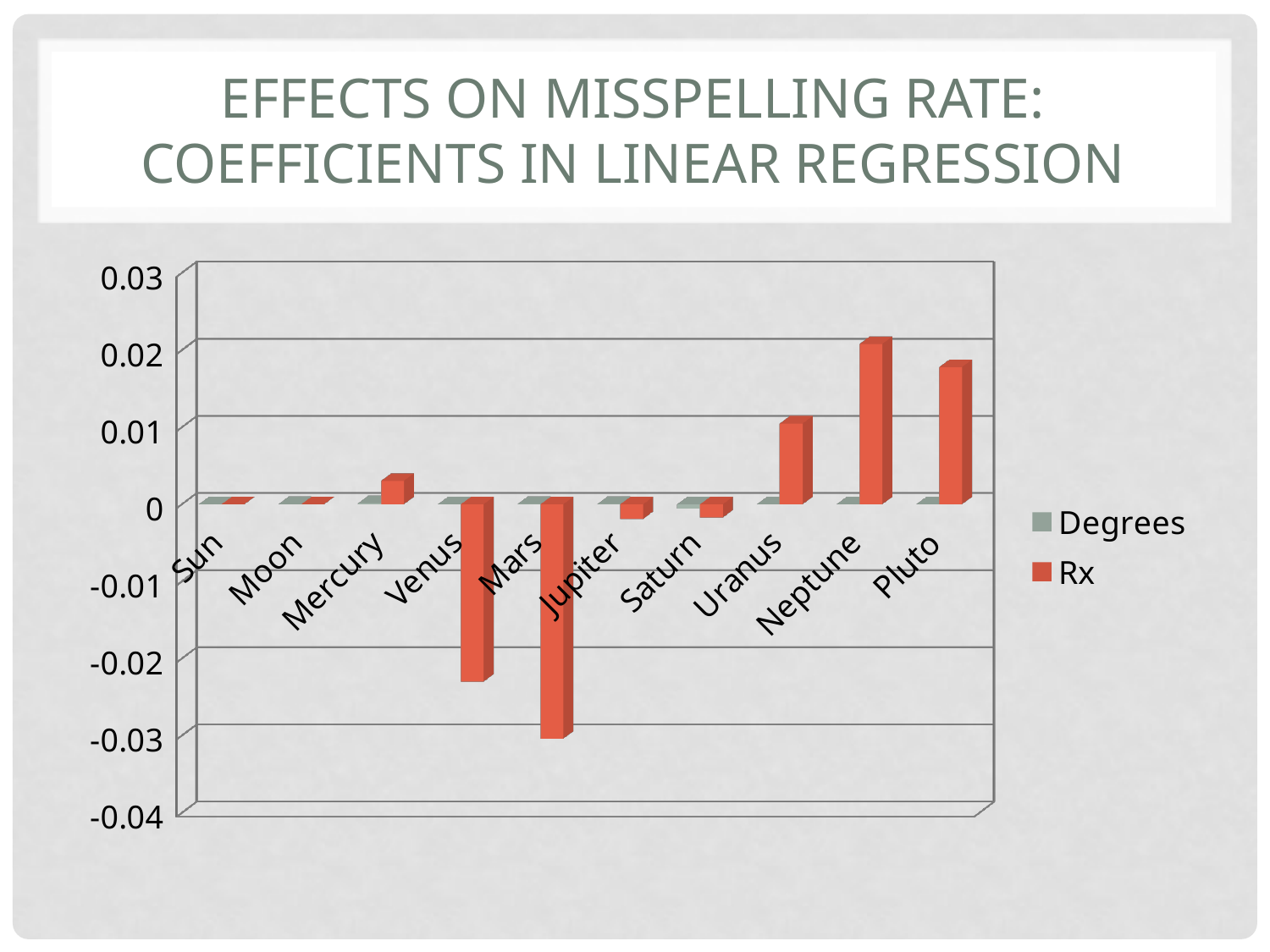
Is the Rx value for Pluto greater or less than 0.01? greater What are the two series named in the legend? Degrees and Rx Is the Rx value for Mars greater or less than -0.02? less Which category has the lowest Rx value? Mars How many series does the legend list? 2 How many categories are shown along the x axis? 10 What kind of chart is shown on the slide? bar chart What is the title of the slide containing the chart? Effects on Misspelling Rate: Coefficients in Linear Regression Is the Rx value for Neptune greater or less than 0.01? greater Which has the larger Rx value, Neptune or Uranus? Neptune Which category has the highest Rx value? Neptune